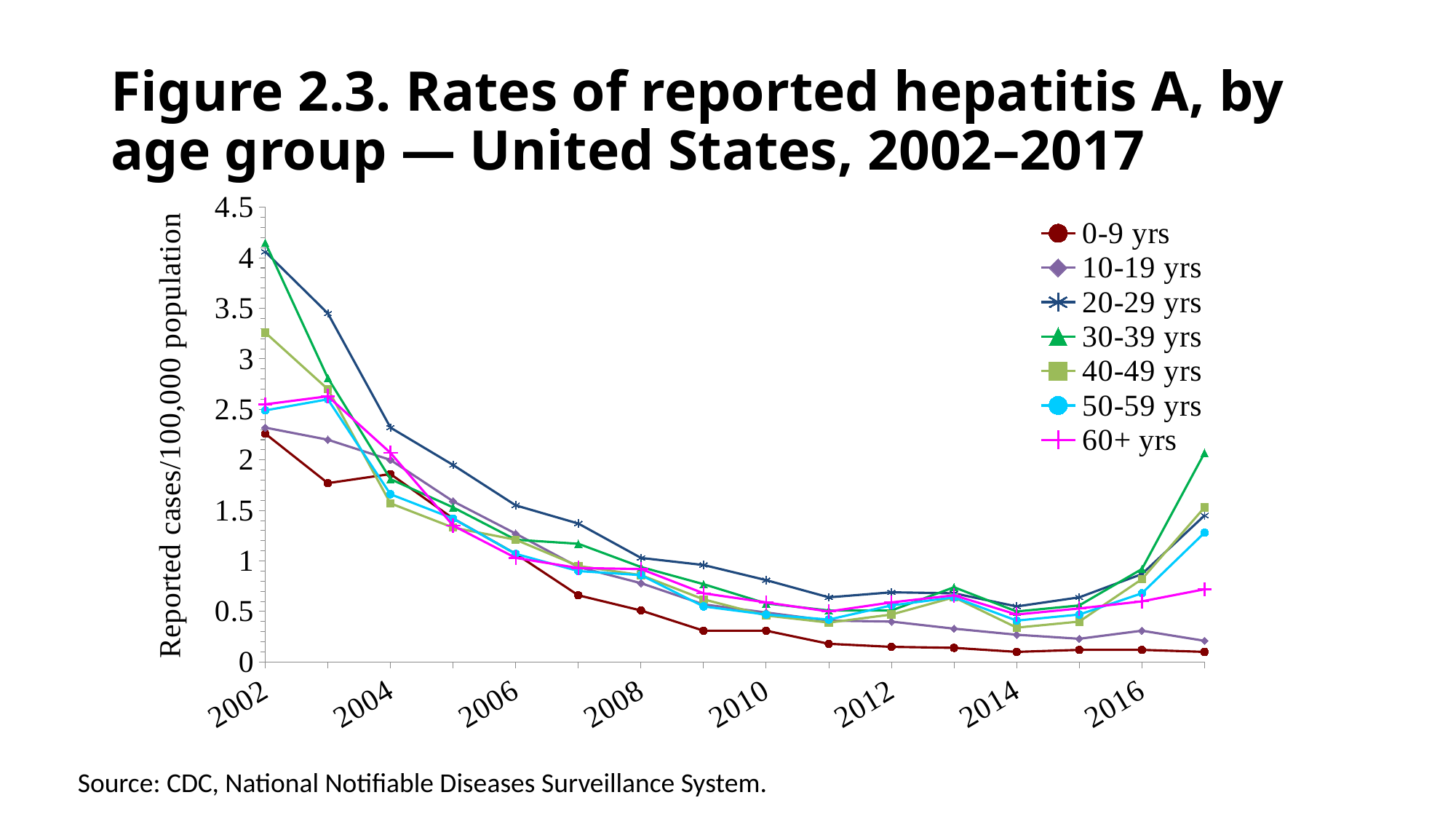
Which age group has the highest rate in 2017? 30-39 yrs How many series does the legend list? 7 Does the rate for 30-39 yrs rise or fall from 2014 to 2017? rise What is the label on the y axis of the chart? Reported cases/100,000 population Is the value for 0-9 yrs in 2017 greater or less than 0.5? less Which age group has the lowest rate in 2017? 0-9 yrs Is the value for 40-49 yrs in 2002 greater or less than 3? greater Does the rate for 0-9 yrs rise or fall from 2002 to 2017? fall Is the value for 60+ yrs in 2017 greater or less than 1? less In 2003, which is larger: the rate for 0-9 yrs or the rate for 20-29 yrs? 20-29 yrs What kind of chart is shown on the slide? line chart